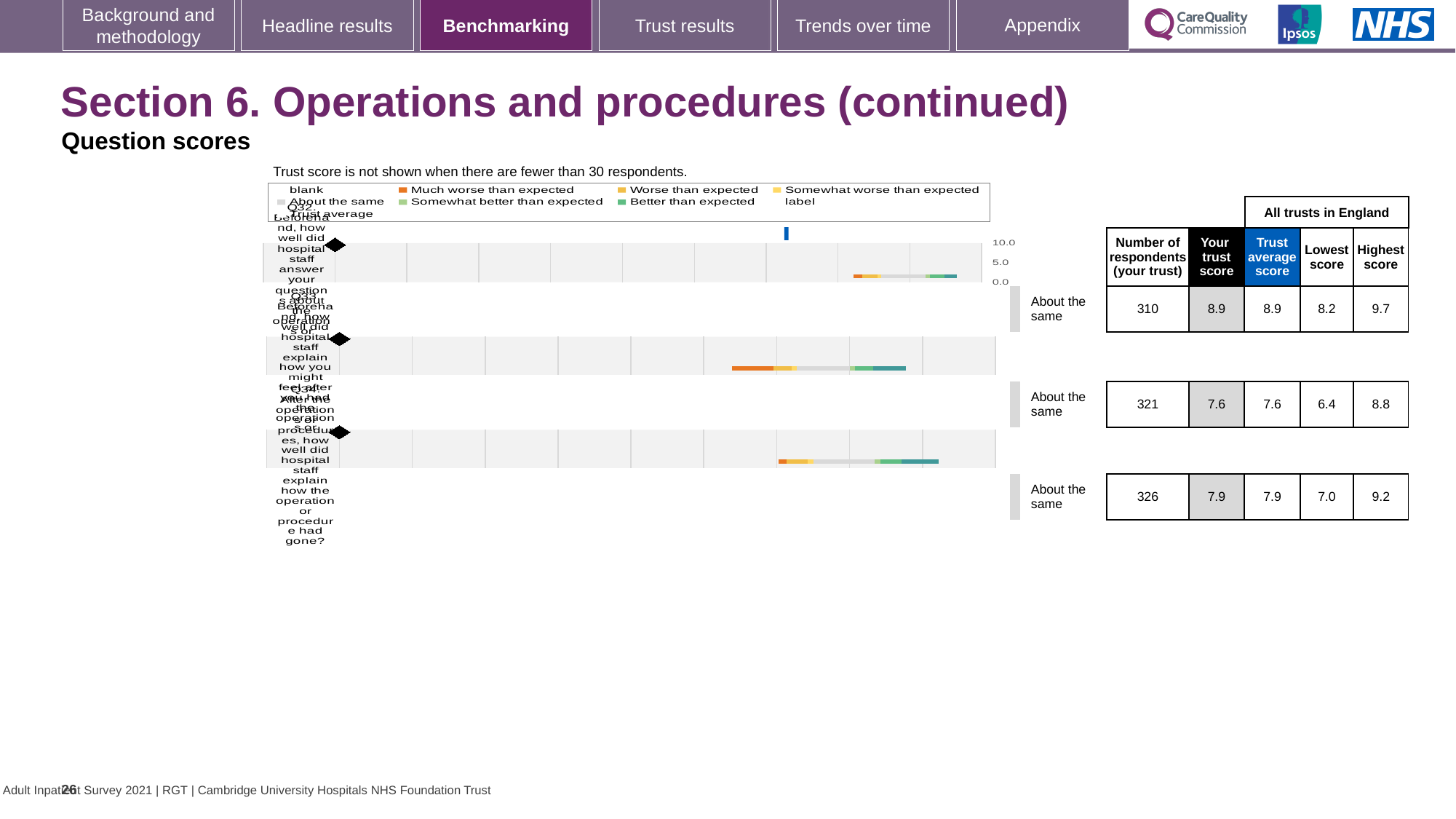
What is the difference between the 'Highest score' and 'Lowest score' for the first question row? 1.5 What benchmark category is shown next to each of the three questions? About the same Which question row has the highest 'Your trust score' in the table? the first row (8.9) Which question row has the lowest 'Lowest score' in the table? the second row (6.4) What kind of chart is used to show the question scores on this slide? bar chart In the table, what is the 'Lowest score' for the third question row (326 respondents)? 7.0 In the table, what is 'Your trust score' for the first question row (310 respondents)? 8.9 In the table, what is the 'Highest score' for the second question row (321 respondents)? 8.8 How many respondents are listed for the second question row in the table? 321 How many questions (rows) are shown in the benchmarking chart and table? 3 Is 'Your trust score' larger for the first question row or the second question row? the first row How many entries does the chart legend list? 9